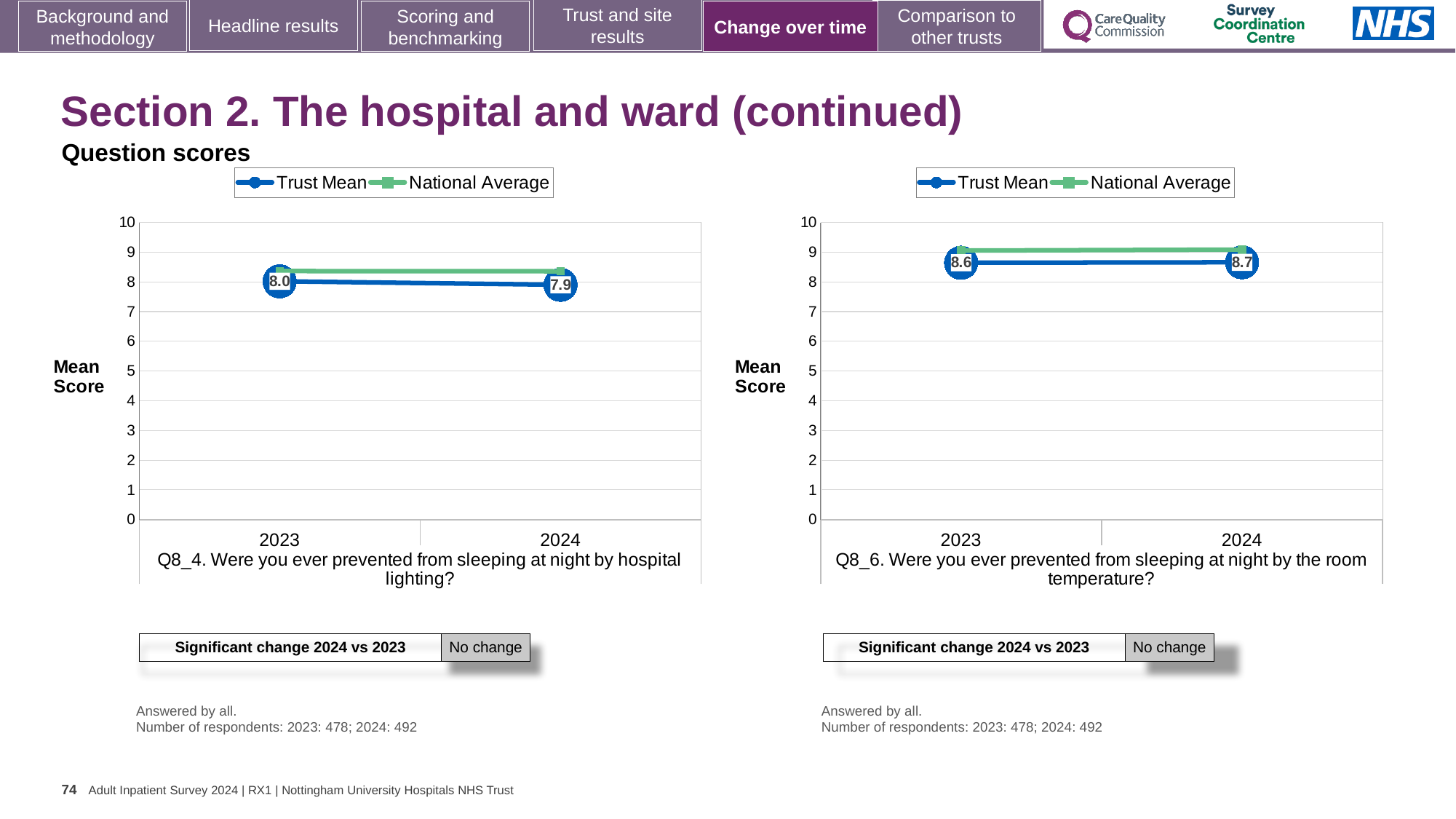
On the right chart (Q8_6), which year has the higher Trust Mean score, 2023 or 2024? 2024 How many series does the legend of the left chart (Q8_4) list? 2 On the right chart (Q8_6), what is the Trust Mean score for 2024? 8.7 On the right chart (Q8_6), what is the Trust Mean score for 2023? 8.6 What kind of chart is the right chart (Q8_6)? Line chart On the right chart (Q8_6), is the National Average value for 2024 greater or less than 8? greater On the left chart (Q8_4), what is the Trust Mean score for 2024? 7.9 On the left chart (Q8_4), does the Trust Mean rise or fall from 2023 to 2024? Fall On the left chart (Q8_4), what is the difference between the Trust Mean scores for 2023 and 2024? 0.1 How many years are plotted on the x axis of the right chart (Q8_6)? 2 On the left chart (Q8_4), what is the Trust Mean score for 2023? 8.0 On the left chart (Q8_4), is the National Average value for 2023 greater or less than 8? greater